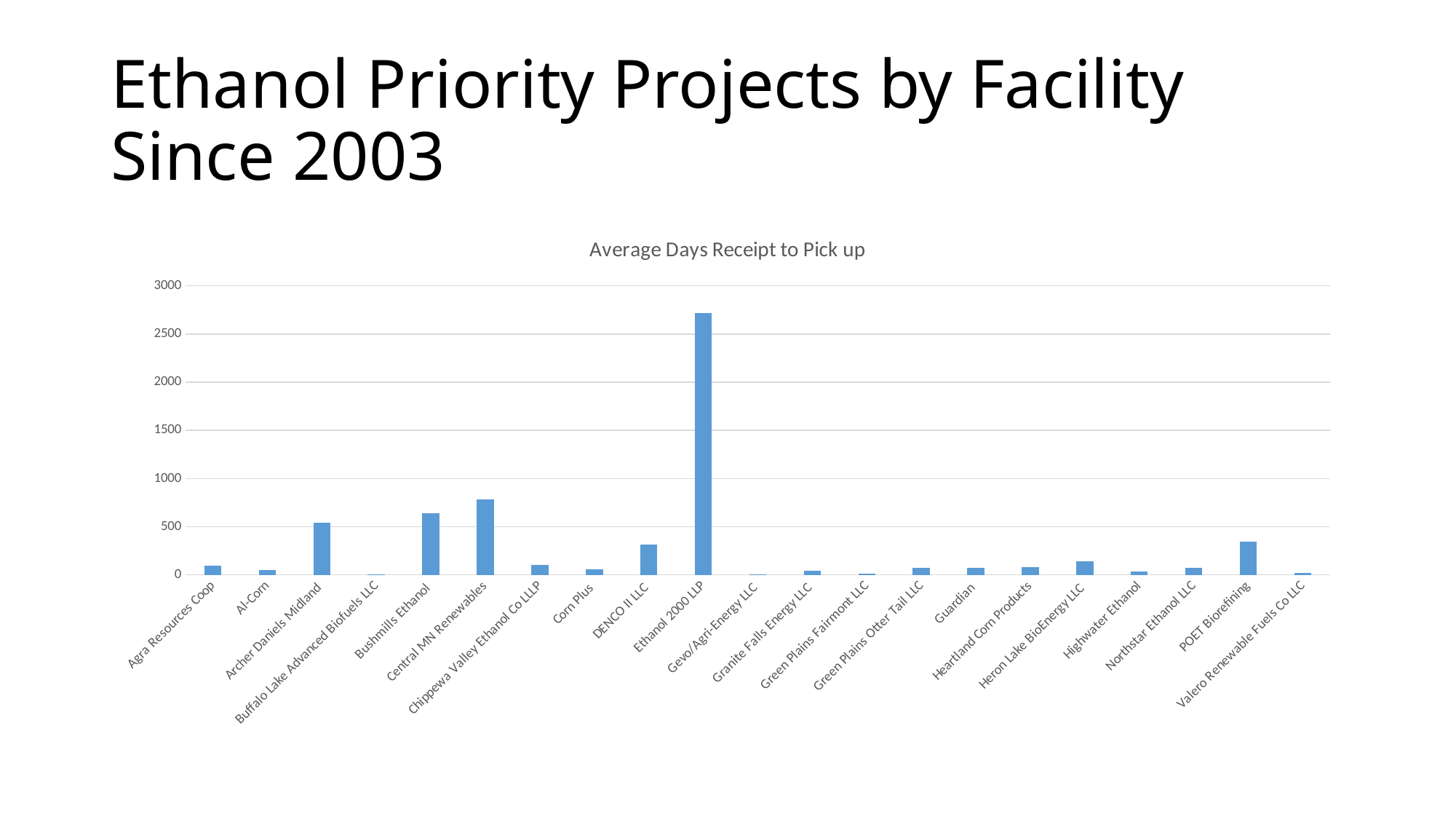
What is the title of the chart? Average Days Receipt to Pick up Is the value for Bushmills Ethanol greater or less than 1000? less Which facility has the highest average days receipt to pick up? Ethanol 2000 LLP Which has a higher value, Central MN Renewables or Bushmills Ethanol? Central MN Renewables Is the value for DENCO II LLC greater or less than 500? less How many facilities are shown on the x axis of the chart? 21 Is the value for Ethanol 2000 LLP greater or less than 2500? greater What kind of chart is shown on the slide? bar chart What colour are the bars in the chart? blue Which has a higher value, Archer Daniels Midland or DENCO II LLC? Archer Daniels Midland